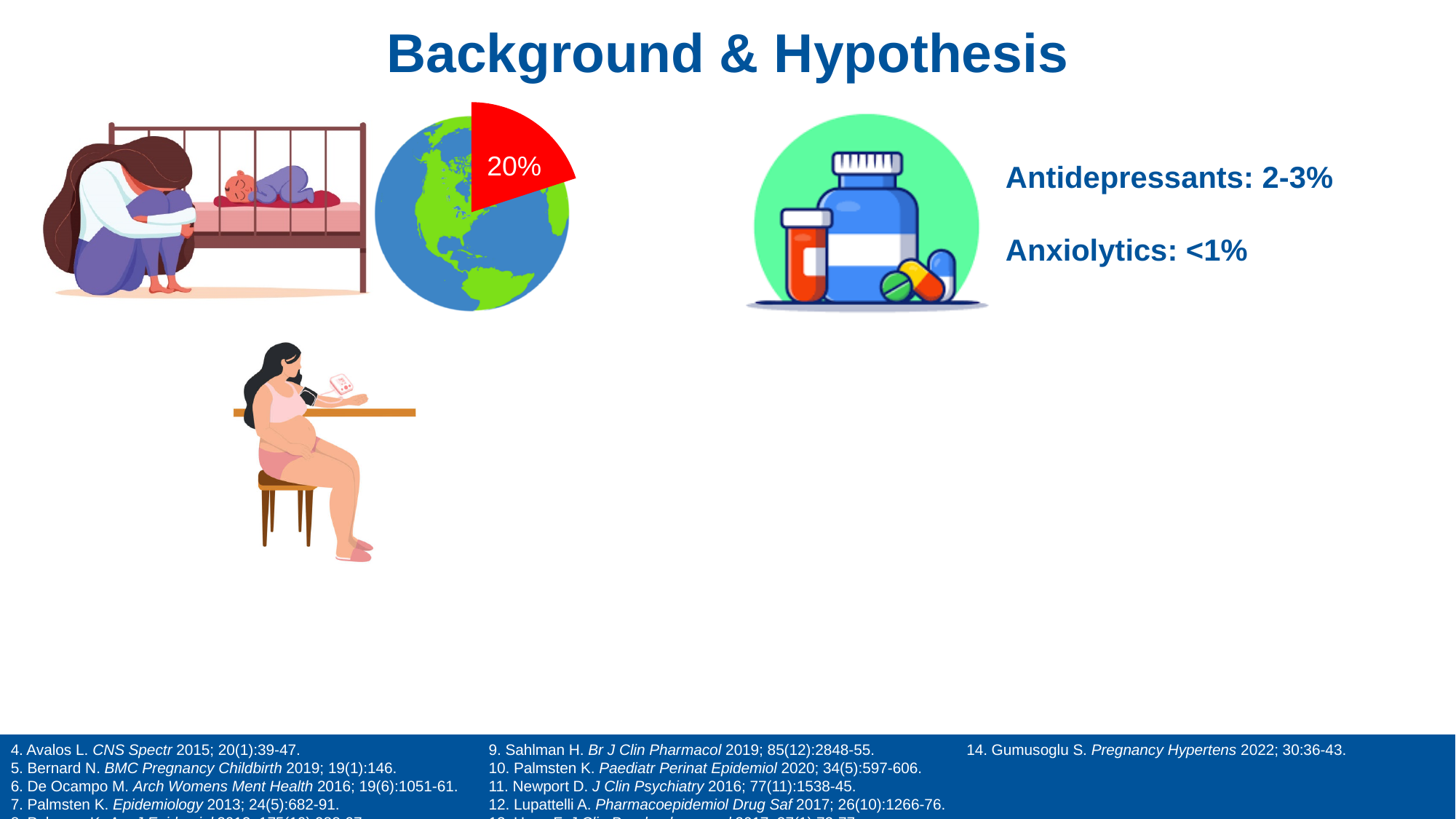
What percentage is printed on the red slice of the pie graphic over the globe? 20% How many labelled slices does the pie graphic over the globe show? 1 What colour is the highlighted slice on the globe pie graphic? red Is the share shown by the red slice on the globe pie graphic greater or less than 50%? less What kind of chart is the red-slice graphic overlaid on the globe? pie chart